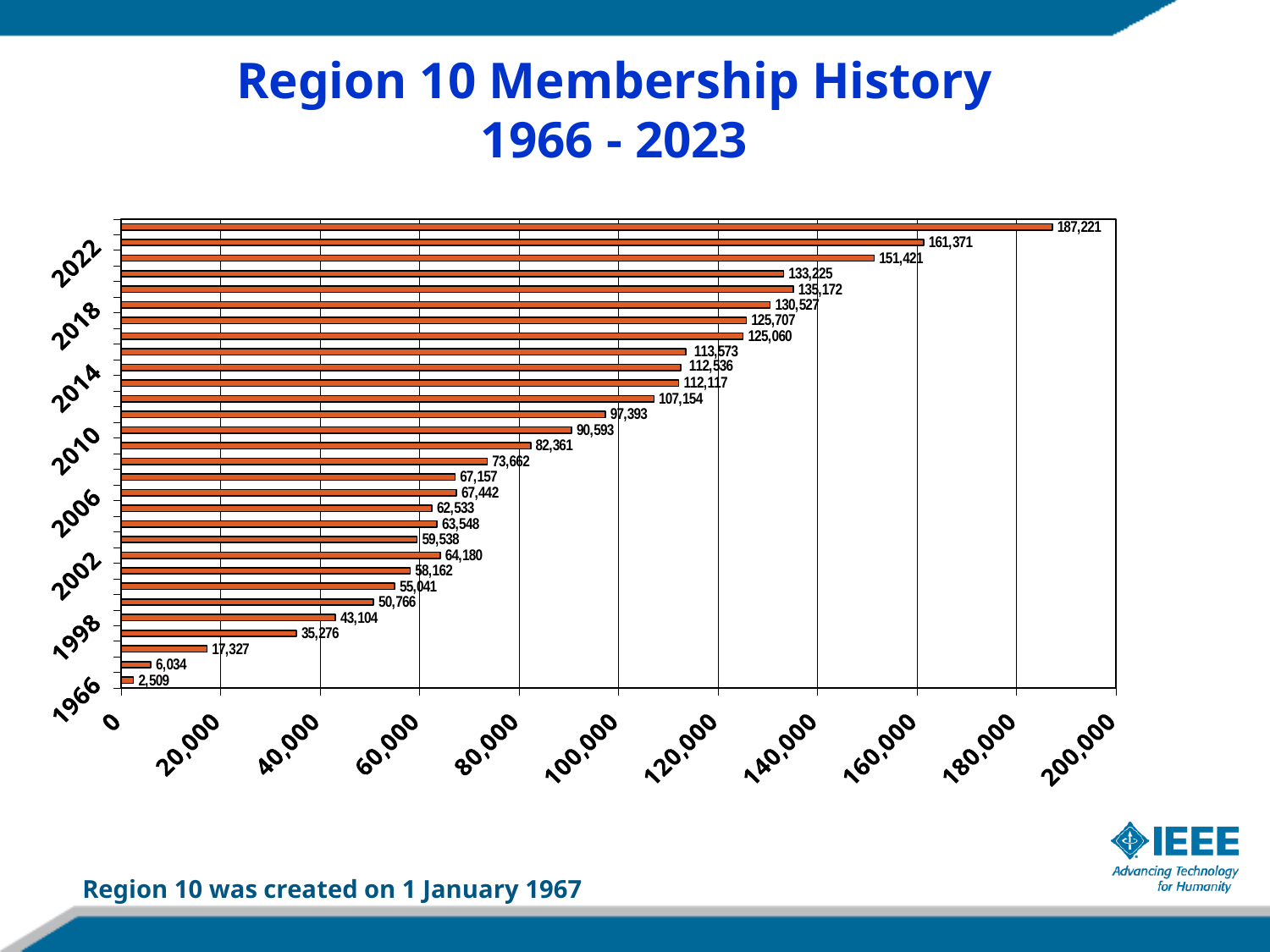
What is the lowest membership value shown in the chart? 2,509 Is the value of the topmost bar greater or less than 180,000? greater What is the value of the longest bar (the topmost bar) in the chart? 187,221 Do membership values generally rise or fall from 1966 at the bottom to 2023 at the top? rise What is the largest value labelled on the horizontal axis? 200,000 What is the difference between the topmost bar (187,221) and the bar directly below it (161,371)? 25,850 What kind of chart is shown on the slide? bar chart What is the highest membership value shown in the chart? 187,221 How many bars are plotted in the chart? 30 What is the membership value shown for 1966? 2,509 Which is larger: the second bar from the top or the third bar from the top? the second bar from the top (161,371) What is the title of the chart? Region 10 Membership History 1966 - 2023